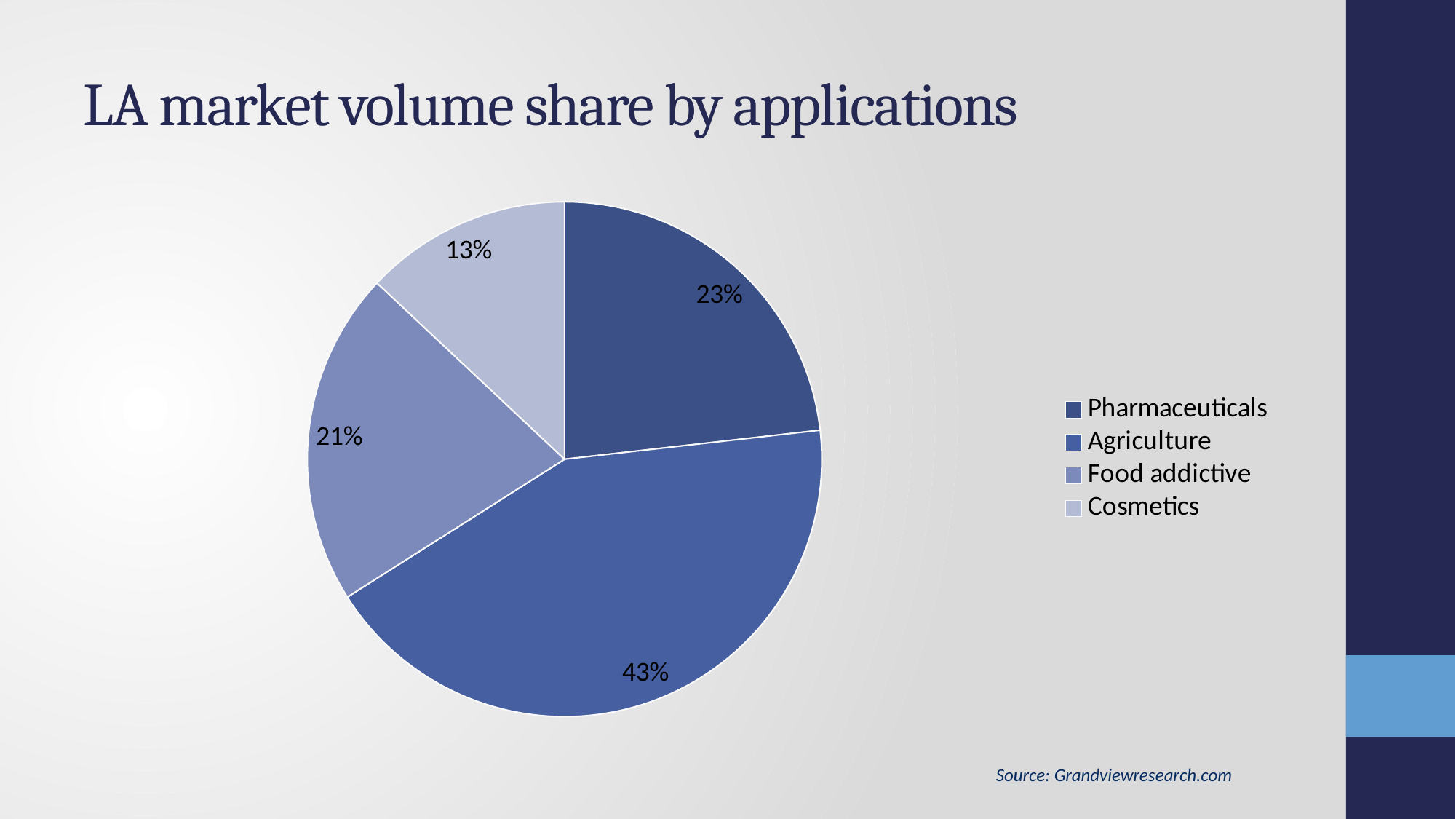
What is the title of the slide containing the pie chart? LA market volume share by applications What share of the pie does Pharmaceuticals hold? 23% What share of the pie does Food addictive hold? 21% What share of the pie does Agriculture hold? 43% What is the difference between the Agriculture share and the Pharmaceuticals share? 20% What type of chart is shown on the slide? pie chart Which has a larger share, Pharmaceuticals or Cosmetics? Pharmaceuticals Which application has the smallest share of the pie? Cosmetics How many slices does the pie chart have? 4 What is the difference between the Food addictive share and the Cosmetics share? 8% Which application has the largest share of the pie? Agriculture